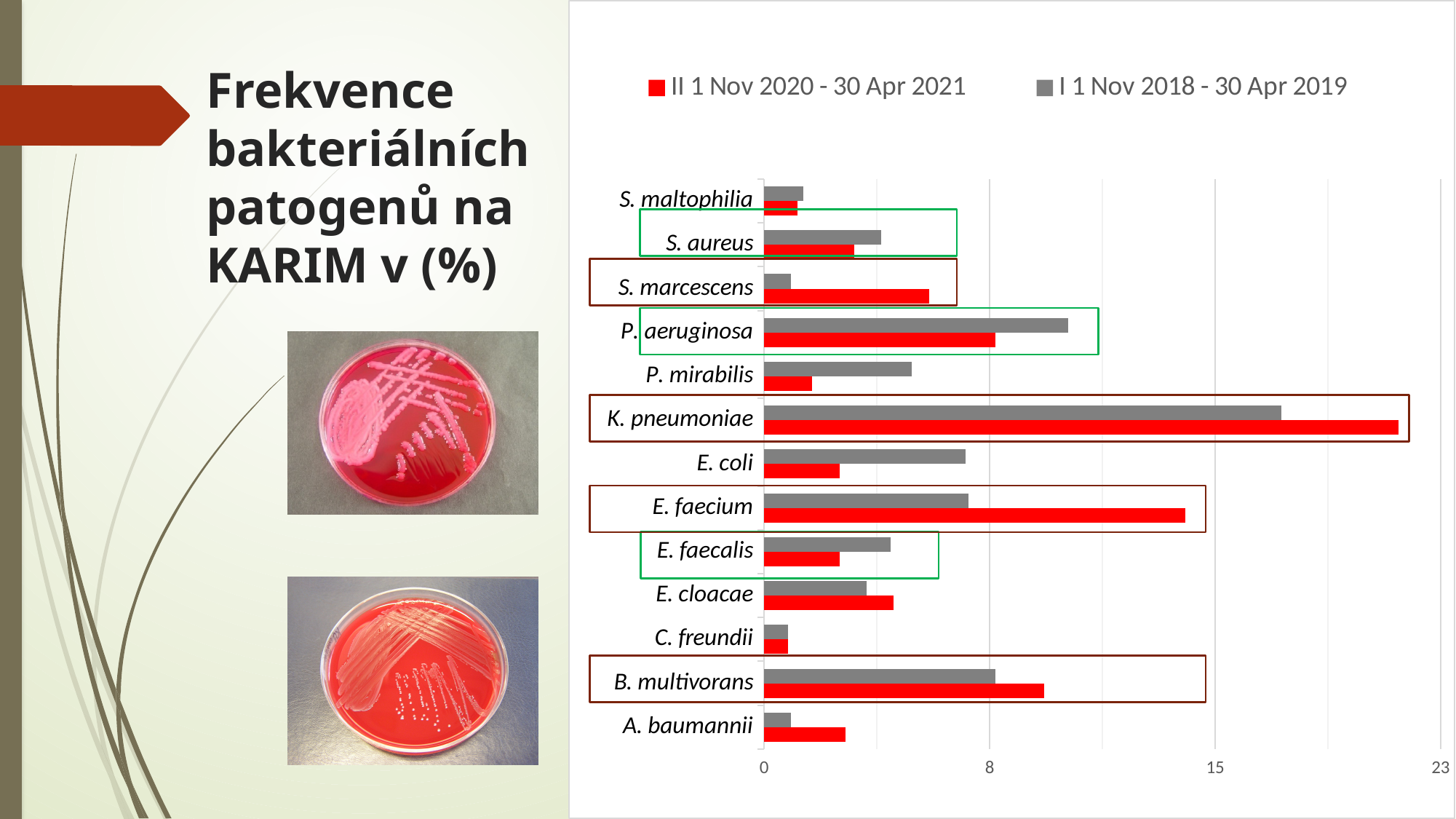
Is the value for K. pneumoniae in the II 1 Nov 2020 - 30 Apr 2021 series greater or less than 15? greater Which colour represents the II 1 Nov 2020 - 30 Apr 2021 series? red Is the value for P. aeruginosa in the I 1 Nov 2018 - 30 Apr 2019 series greater or less than 8? greater Is the value for B. multivorans in the II 1 Nov 2020 - 30 Apr 2021 series greater or less than 8? greater How many bacterial pathogens (categories) are plotted on the chart? 13 For P. aeruginosa, which series has the larger value: II 1 Nov 2020 - 30 Apr 2021 or I 1 Nov 2018 - 30 Apr 2019? I 1 Nov 2018 - 30 Apr 2019 What kind of chart is shown on the slide? bar chart Which pathogen has the highest value in the I 1 Nov 2018 - 30 Apr 2019 series? K. pneumoniae Which pathogen has the highest value in the II 1 Nov 2020 - 30 Apr 2021 series? K. pneumoniae For S. marcescens, which series has the larger value: II 1 Nov 2020 - 30 Apr 2021 or I 1 Nov 2018 - 30 Apr 2019? II 1 Nov 2020 - 30 Apr 2021 How many series does the legend list? 2